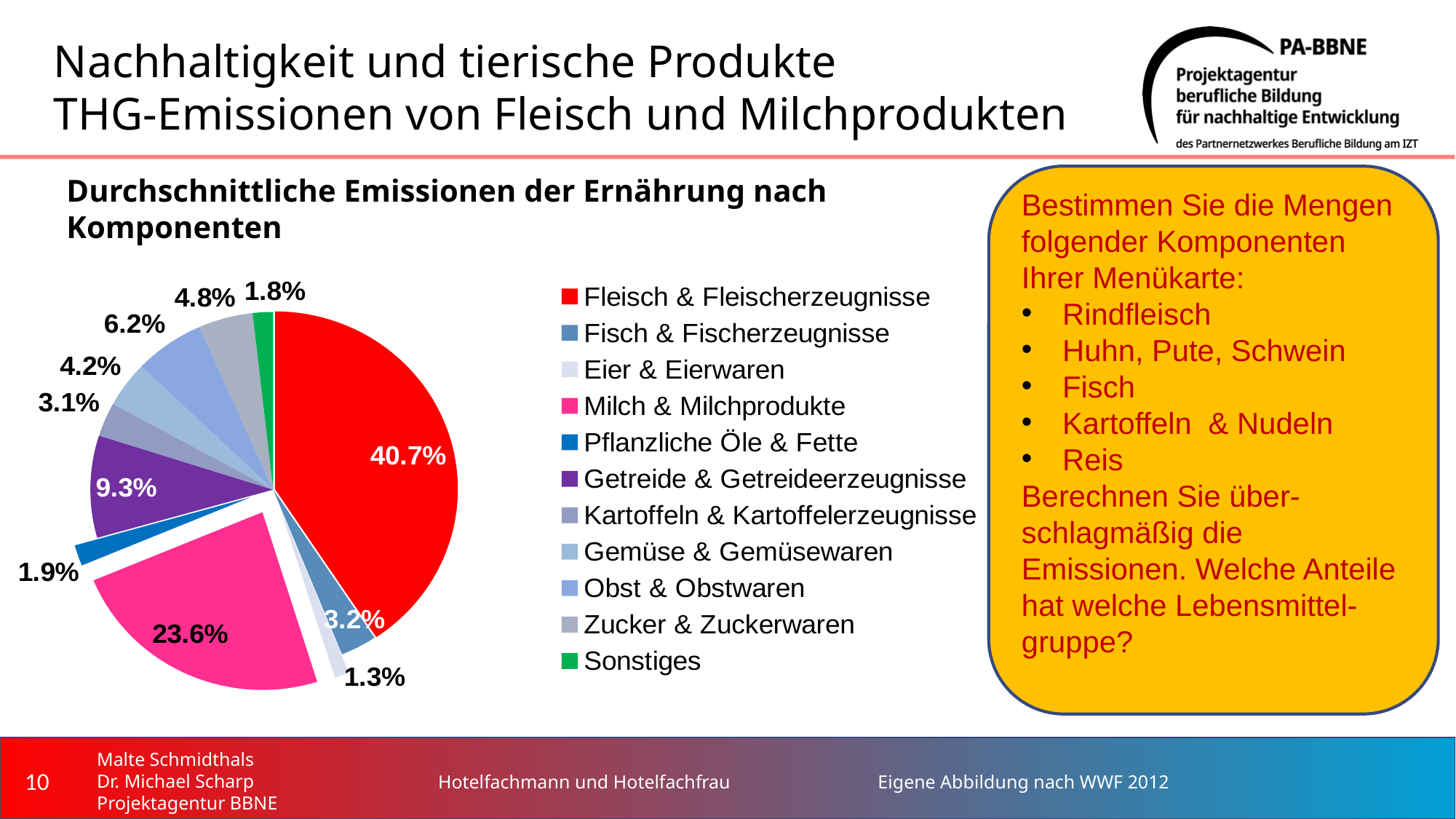
What is the value shown for Milch & Milchprodukte? 23.6% What share is shown for Obst & Obstwaren? 6.2% Which is larger, the share for Zucker & Zuckerwaren or the share for Gemüse & Gemüsewaren? Zucker & Zuckerwaren What share of the pie does Fleisch & Fleischerzeugnisse account for? 40.7% What percentage is shown for Getreide & Getreideerzeugnisse? 9.3% What is the value for Fisch & Fischerzeugnisse? 3.2% Which category has the largest slice of the pie? Fleisch & Fleischerzeugnisse What is the title of the chart? Durchschnittliche Emissionen der Ernährung nach Komponenten What type of chart is shown on the slide? Pie chart How many categories does the pie chart show? 11 Which category has the smallest slice of the pie? Eier & Eierwaren What is the difference in percentage points between Fleisch & Fleischerzeugnisse and Milch & Milchprodukte? 17.1